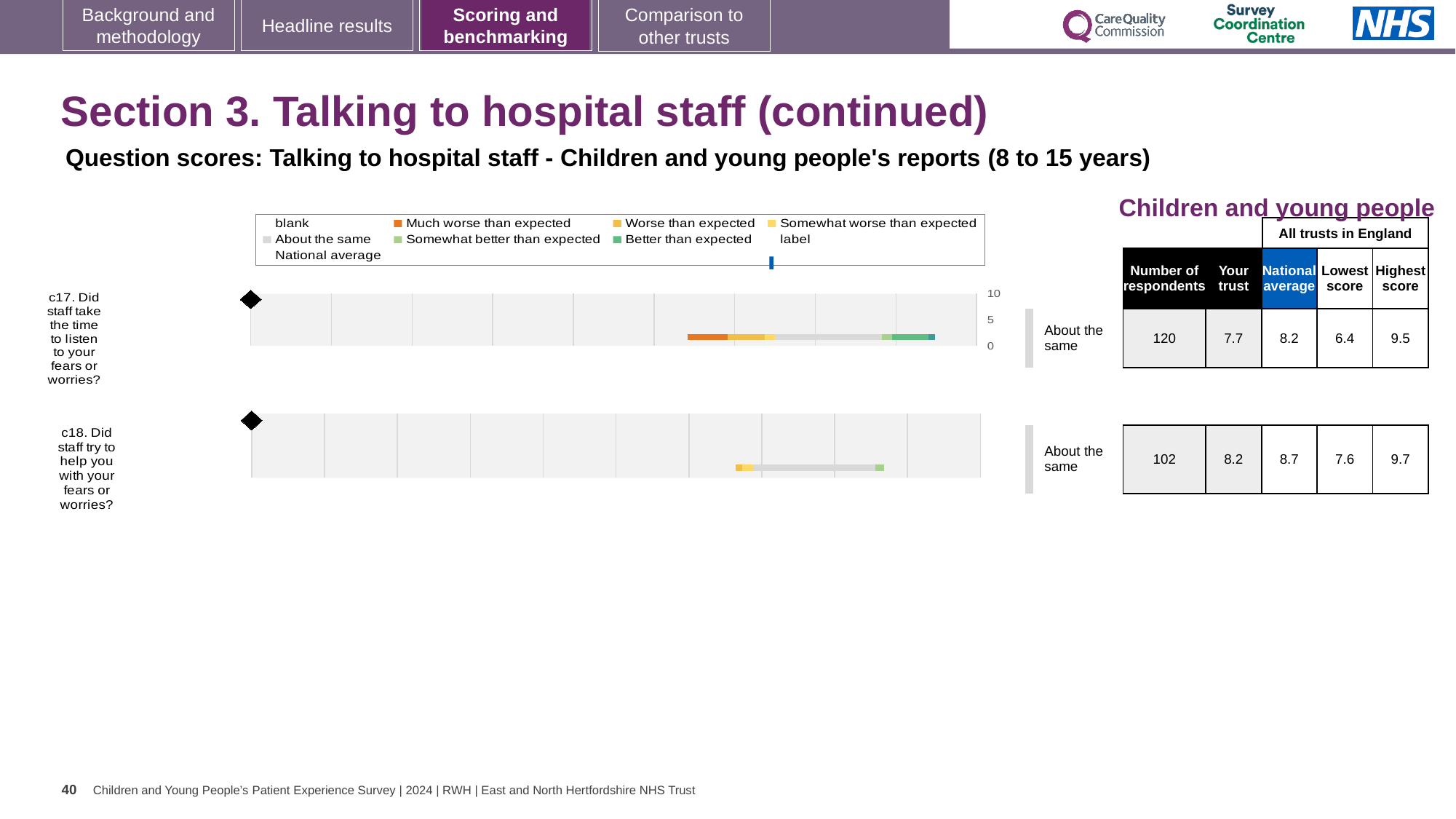
What is the lowest score among all trusts in England for question c17? 6.4 For question c18, how much higher is the national average than the trust's score? 0.5 What is the national average score for question c17? 8.2 How many survey questions are plotted on this slide? 2 For question c17, what is the difference between the highest and lowest scores among all trusts in England? 3.1 What is the highest score among all trusts in England for question c18? 9.7 What is the number of respondents for question c18? 102 What is the 'Your trust' score for question c18 (Did staff try to help you with your fears or worries?)? 8.2 Which question has the higher 'Your trust' score, c17 or c18? c18 What kind of chart is used to show the question scores on this slide? Bar chart How many respondents are shown for question c17 (Did staff take the time to listen to your fears or worries?)? 120 What benchmark category is the trust's score for question c17 placed in? About the same